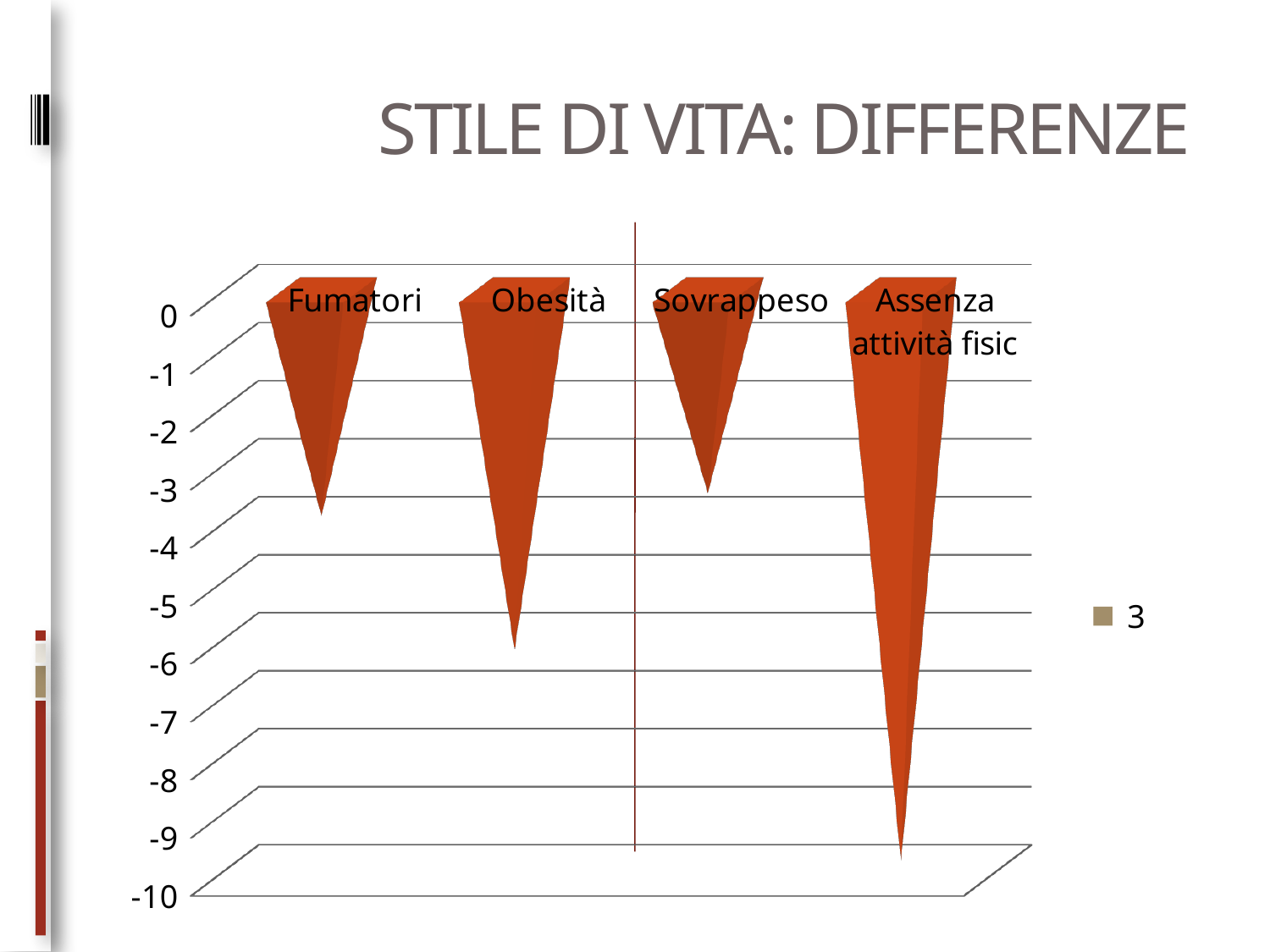
What kind of chart is shown on the slide? bar chart Which has the larger (less negative) value, Fumatori or Obesità? Fumatori Is the value for Obesità greater or less than -4? less Is the value for Assenza attività fisica greater or less than -8? less How many series does the legend list? 1 Is the value for Sovrappeso greater or less than -2? less Which has the lower (more negative) value, Obesità or Assenza attività fisica? Assenza attività fisica Which category has the lowest (most negative) value? Assenza attività fisic How many categories are plotted in the chart? 4 What is the title of the chart on the slide? STILE DI VITA: DIFFERENZE What is the legend entry shown for the series? 3